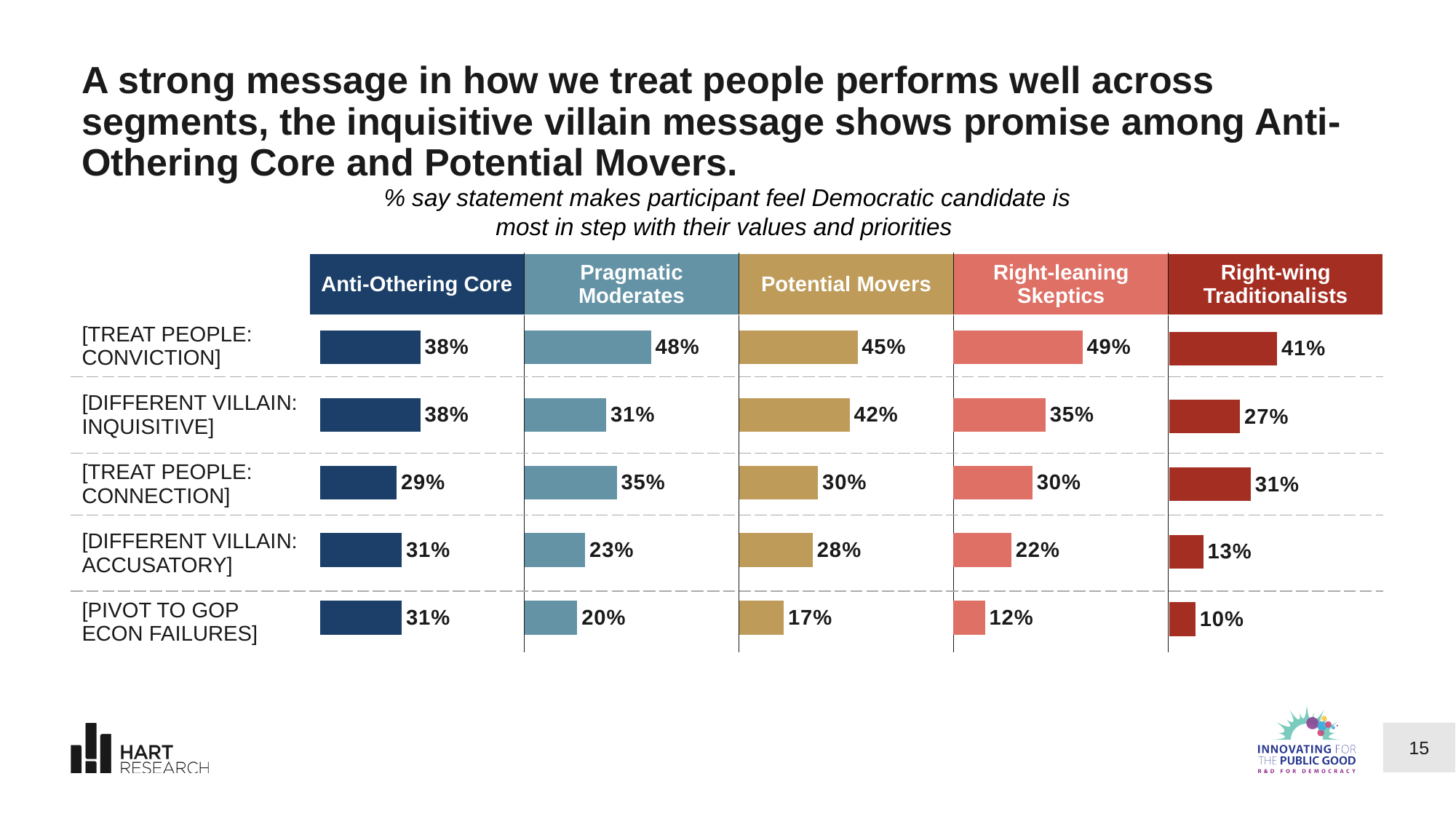
Which segment has the highest value for the [TREAT PEOPLE: CONVICTION] statement? Right-leaning Skeptics How many voter segments are shown as column headers in the chart? 5 How many statements are shown as rows in the chart? 5 What type of chart is used on this slide? Bar chart For the [DIFFERENT VILLAIN: ACCUSATORY] statement, which is larger: the Anti-Othering Core value or the Potential Movers value? Anti-Othering Core What percentage of Potential Movers say the [DIFFERENT VILLAIN: INQUISITIVE] statement makes them feel the Democratic candidate is most in step with their values? 42% What is the value for Anti-Othering Core on the [TREAT PEOPLE: CONNECTION] statement? 29% What is the value for Right-wing Traditionalists on the [PIVOT TO GOP ECON FAILURES] statement? 10% Among Right-leaning Skeptics, which statement has the highest percentage? [TREAT PEOPLE: CONVICTION] Among Pragmatic Moderates, which statement has the lowest percentage? [PIVOT TO GOP ECON FAILURES] For Right-wing Traditionalists, how much higher is [TREAT PEOPLE: CONVICTION] than [DIFFERENT VILLAIN: ACCUSATORY]? 28 percentage points For Pragmatic Moderates, what is the difference between the [TREAT PEOPLE: CONVICTION] value and the [DIFFERENT VILLAIN: INQUISITIVE] value? 17 percentage points